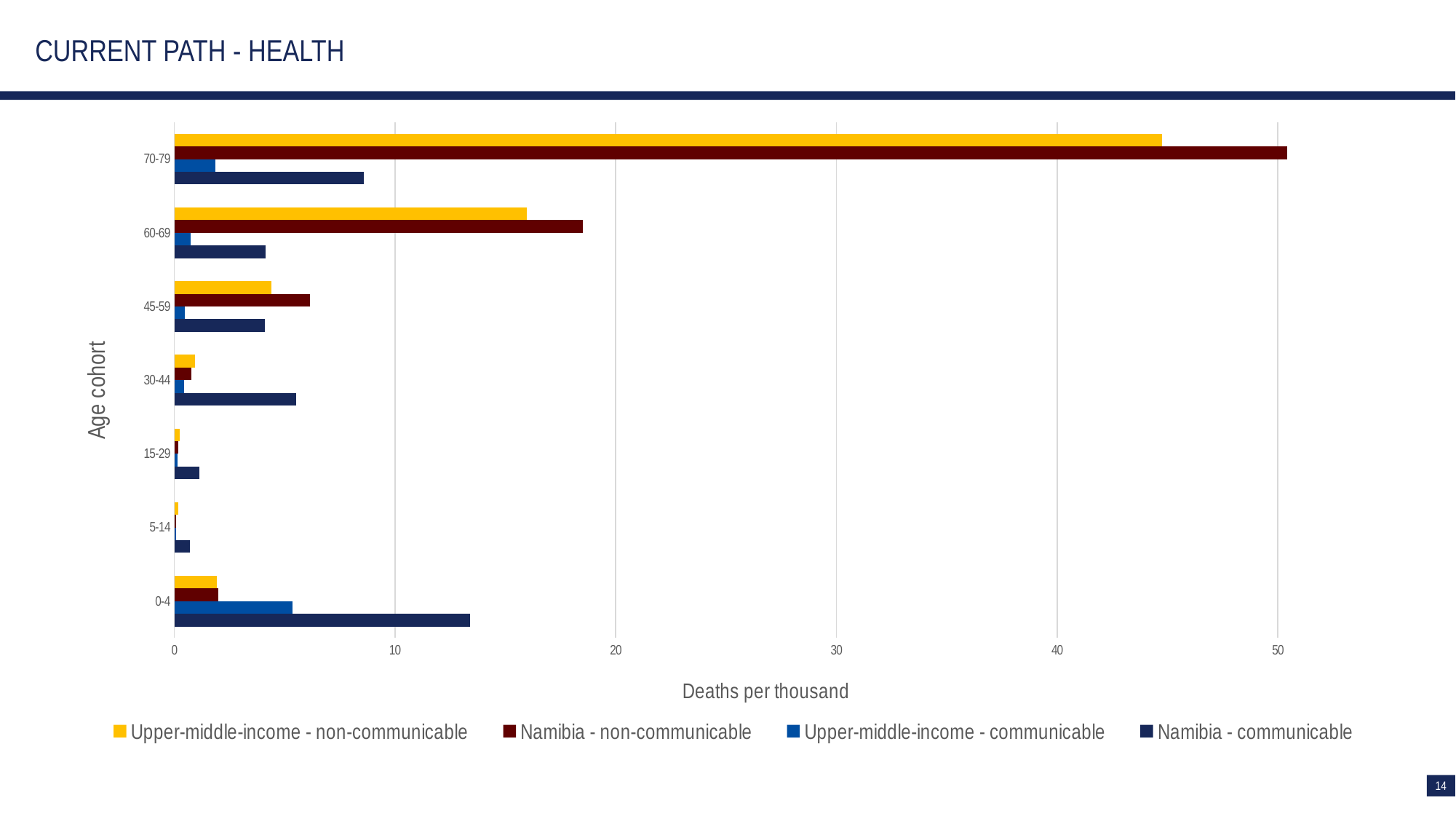
Is the Upper-middle-income - non-communicable value for the 70-79 cohort greater or less than 50? less What is the title of the x axis? Deaths per thousand For which age cohort is the Namibia - communicable value highest? 0-4 How many age cohorts are shown on the y axis? 7 For which age cohort is the Namibia - non-communicable value highest? 70-79 Is the Namibia - non-communicable value for the 70-79 cohort greater or less than 40? greater In the 0-4 cohort, which is larger: Namibia - communicable or Upper-middle-income - communicable? Namibia - communicable For which age cohort is the Namibia - communicable value lowest? 5-14 Is the Namibia - non-communicable value for the 60-69 cohort greater or less than 20? less How many series does the legend list? 4 What kind of chart is shown on the slide? Bar chart